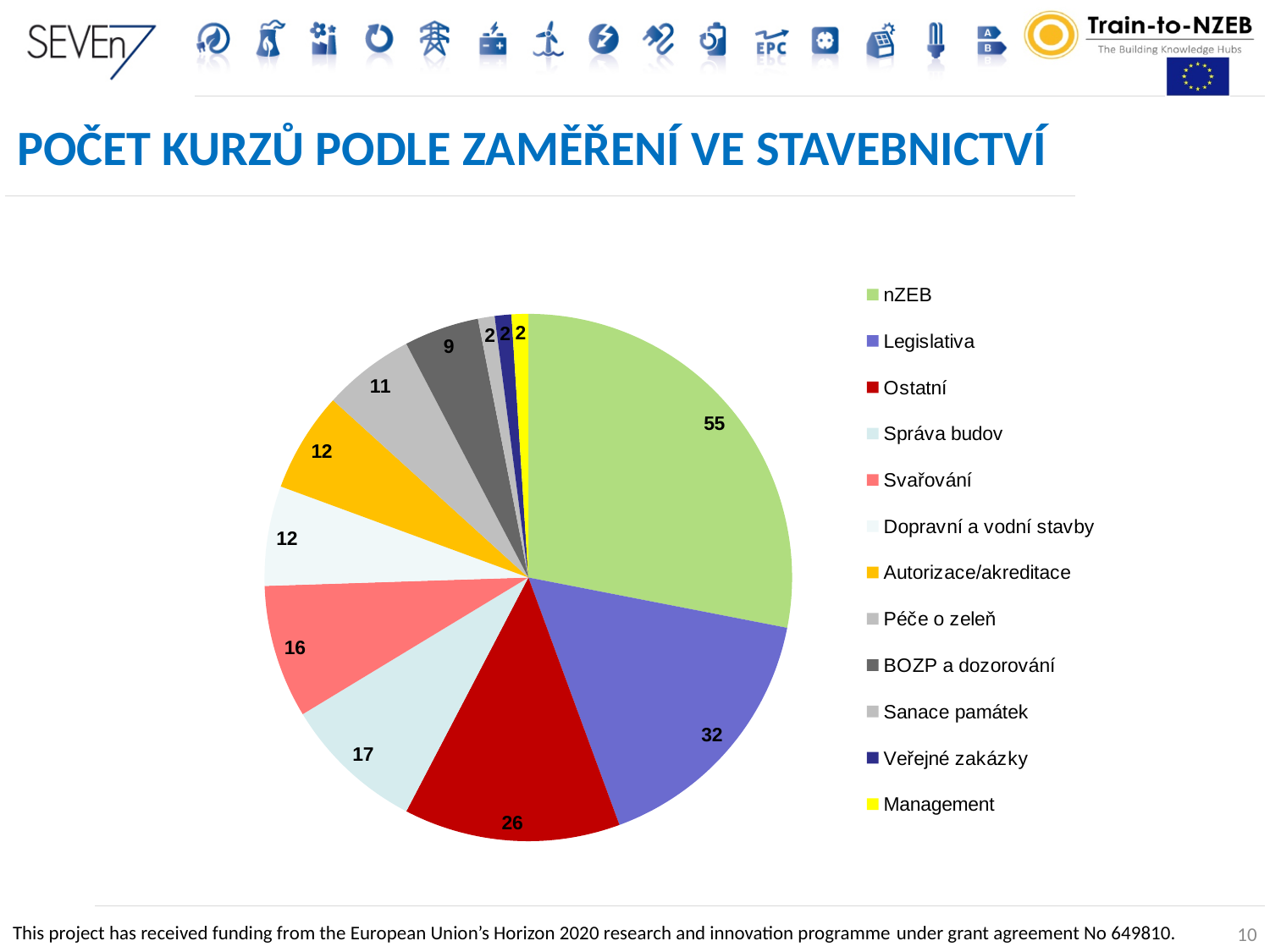
What kind of chart is shown on the slide? pie chart Which category has the largest slice of the pie? nZEB What is the title of the chart on the slide? POČET KURZŮ PODLE ZAMĚŘENÍ VE STAVEBNICTVÍ What is the value for BOZP a dozorování? 9 How many courses are shown for nZEB? 55 How many categories does the legend list? 12 What is the value for Legislativa? 32 What is the difference between the values for Ostatní and Správa budov? 9 What is the value for Svařování? 16 What is the total of all the values in the pie chart? 196 Which is larger, the value for Péče o zeleň or the value for Svařování? Svařování What is the difference between the values for nZEB and Legislativa? 23